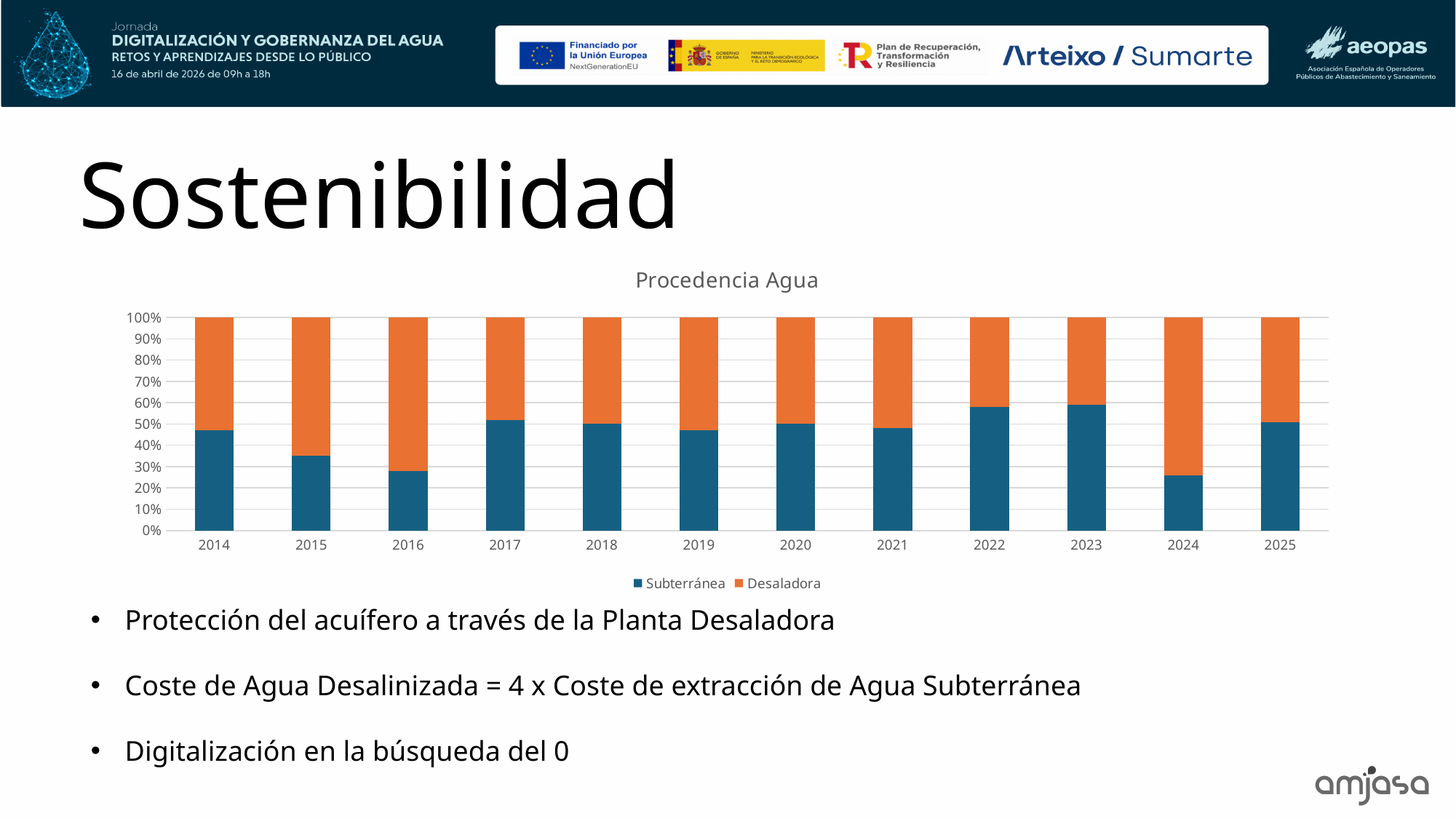
What is the total height of each stacked bar in the chart? 100% How many years are shown along the x axis of the chart? 12 Is the Subterránea share in 2024 greater or less than 30%? less Which year has the larger Subterránea share, 2015 or 2022? 2022 Which year has the larger Desaladora share, 2016 or 2017? 2016 Is the Subterránea share in 2022 greater or less than 50%? greater How many series does the chart legend list? 2 Is the Desaladora share in 2024 greater or less than 70%? greater What kind of chart is shown on the slide? Stacked bar chart What is the title of the chart? Procedencia Agua Which colour represents Subterránea in the chart? Blue